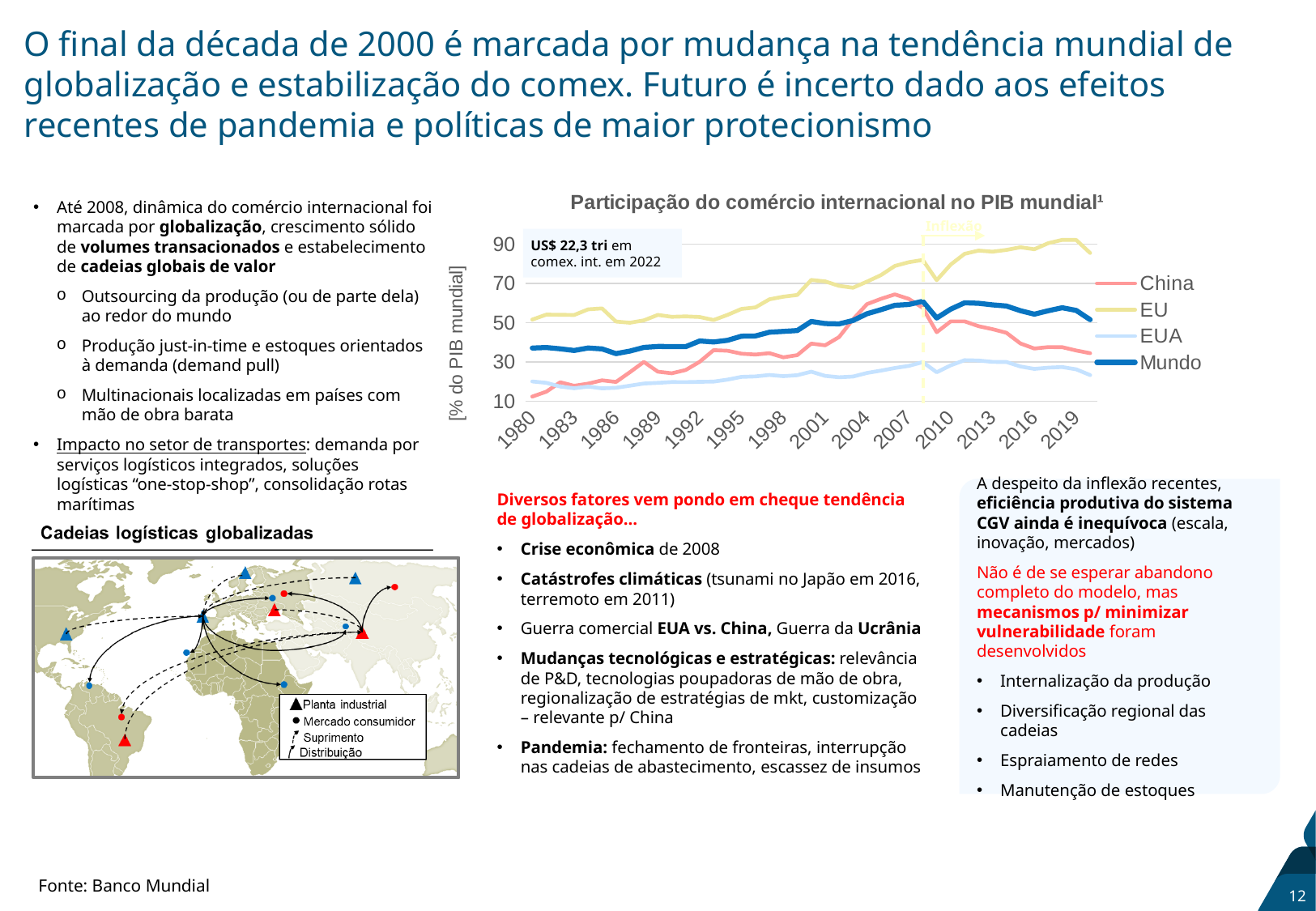
Is the value for EUA in 2019 greater or less than 30? less Does the China series rise or fall from 2007 to 2019? fall What kind of chart is shown under the title 'Participação do comércio internacional no PIB mundial'? line chart Does the EU series rise or fall overall from 1980 to 2019? rise Is the value for EU in 2019 greater or less than 70? greater Is the value for China in 1980 greater or less than 30? less In 2019, which is larger: the value for China or the value for EUA? China How many series does the legend of the chart list? 4 Which series has the lowest value in 1980? China Which series has the highest value in 2019? EU Which series are listed in the legend of the chart? China, EU, EUA, Mundo What is the label of the vertical axis of the chart? [% do PIB mundial]